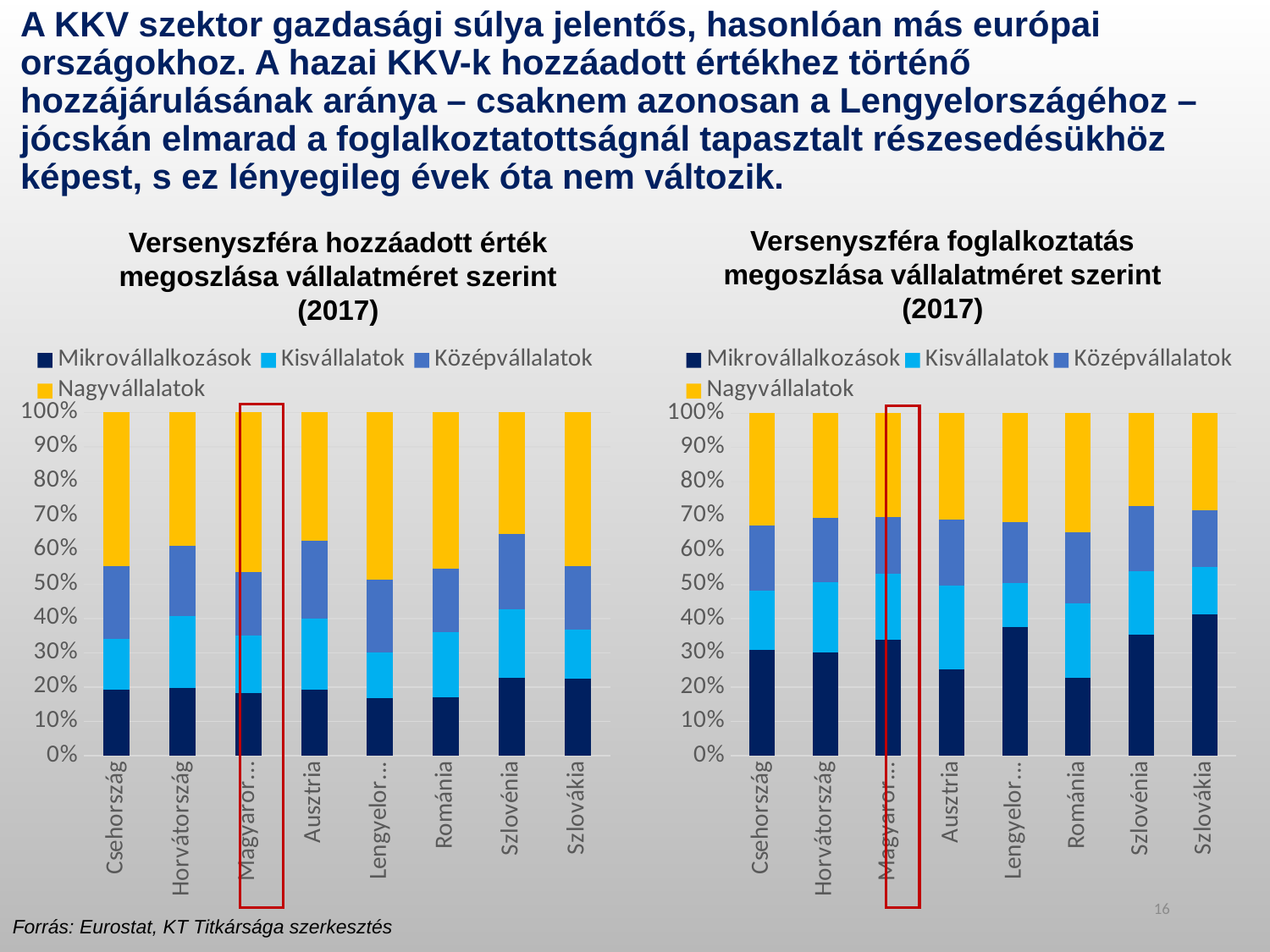
What year do both chart titles refer to? 2017 In the right chart (foglalkoztatás), is the Mikrovállalkozások share for Románia greater or less than 30%? less Which series is shown in yellow in both charts? Nagyvállalatok How many series does the legend of the left chart list? 4 What kind of chart is the left chart, 'Versenyszféra hozzáadott érték megoszlása vállalatméret szerint (2017)'? Stacked bar chart In the left chart (hozzáadott érték), is the Mikrovállalkozások share larger for Szlovénia or for Ausztria? Szlovénia In the right chart (foglalkoztatás), is the Mikrovállalkozások share for Ausztria greater or less than 30%? less In the left chart (hozzáadott érték), is the Mikrovállalkozások share for Szlovénia greater or less than 20%? greater How many countries are shown on the x axis of the right chart, 'Versenyszféra foglalkoztatás megoszlása vállalatméret szerint (2017)'? 8 In the right chart (foglalkoztatás), is the Mikrovállalkozások share larger for Szlovákia or for Csehország? Szlovákia In the right chart (foglalkoztatás), which country has the largest Mikrovállalkozások share? Szlovákia